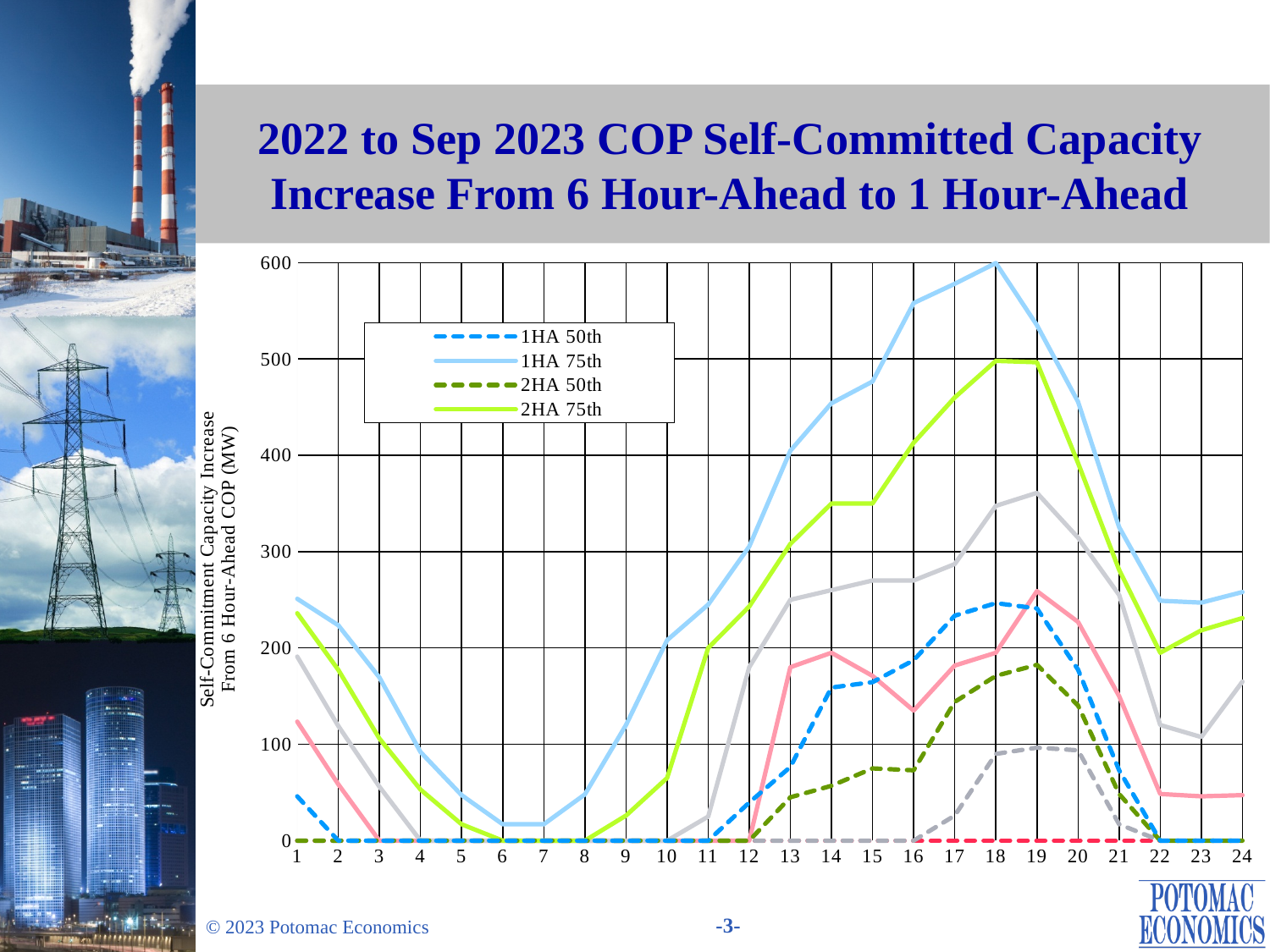
At hour 14, which series is higher: 1HA 75th or 2HA 75th? 1HA 75th At hour 3, which series is higher: 1HA 75th or 2HA 75th? 1HA 75th Is the value for 2HA 75th at hour 6 greater or less than 100? less How many hours are shown along the x axis? 24 Is the value for 1HA 50th at hour 18 greater or less than 200? greater At which hour does the 1HA 75th series reach its highest value? 18 What is the value for 1HA 50th at hour 8? 0 Does the 1HA 75th series rise or fall from hour 1 to hour 6? fall Is the value for 1HA 75th at hour 18 greater or less than 500? greater What is the y-axis title of the chart? Self-Commitment Capacity Increase From 6 Hour-Ahead COP (MW) How many series does the legend list? 4 What kind of chart is shown on the slide? line chart